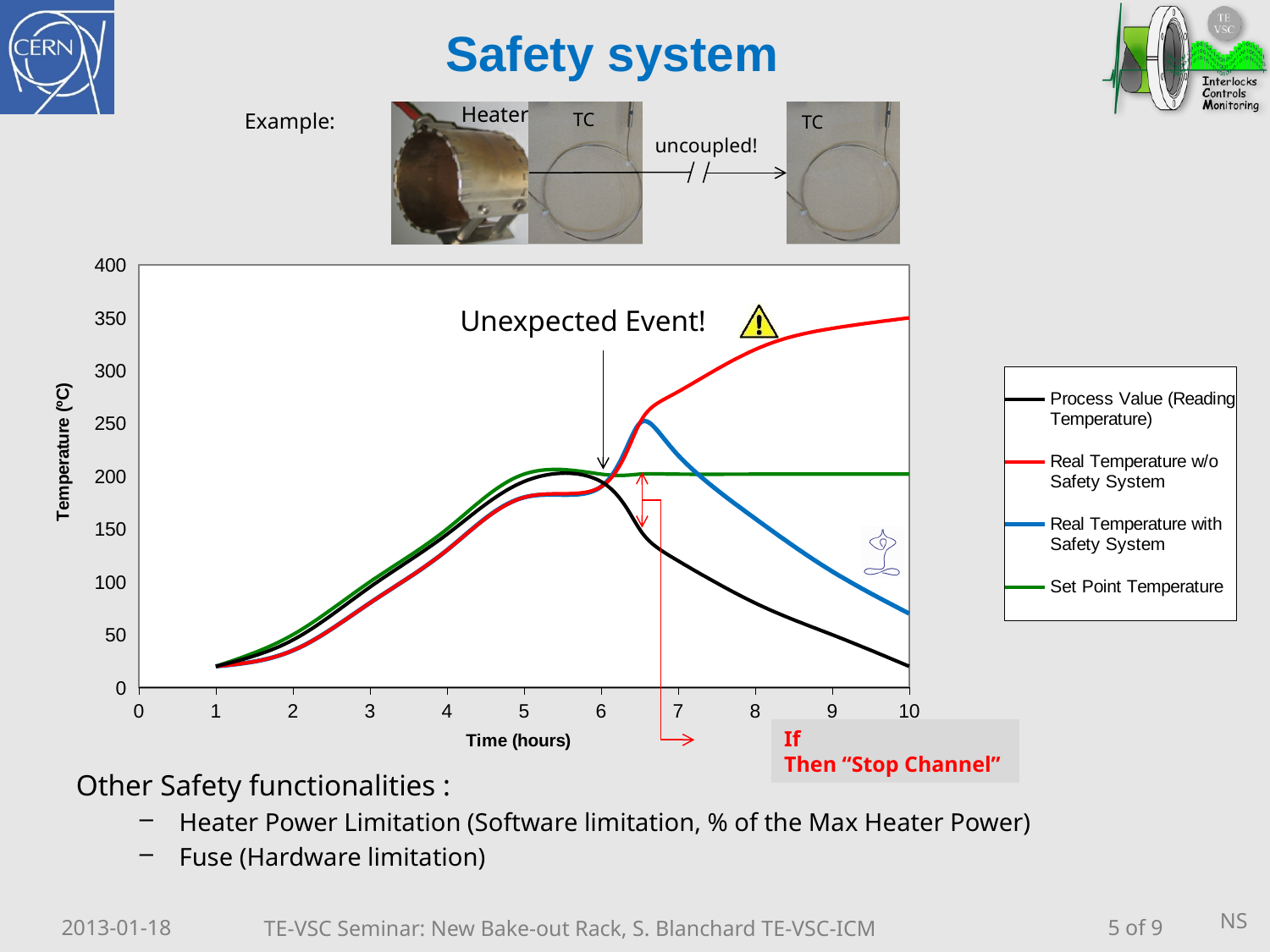
Is the value of Real Temperature w/o Safety System at 10 hours greater or less than 300? greater Which series has the lowest value at 10 hours? Process Value (Reading Temperature) Is the peak value of Real Temperature with Safety System greater or less than 200? greater How many series does the chart legend list? 4 What is the title of the x axis of the chart? Time (hours) Is the value of Real Temperature with Safety System at 10 hours greater or less than 100? less What kind of chart is shown on the slide? line chart Does the Real Temperature w/o Safety System series rise or fall between 6 and 10 hours? rise At 10 hours, which is larger: Real Temperature w/o Safety System or Real Temperature with Safety System? Real Temperature w/o Safety System At 10 hours, which is larger: Real Temperature with Safety System or Process Value (Reading Temperature)? Real Temperature with Safety System Which series has the highest value at 10 hours? Real Temperature w/o Safety System